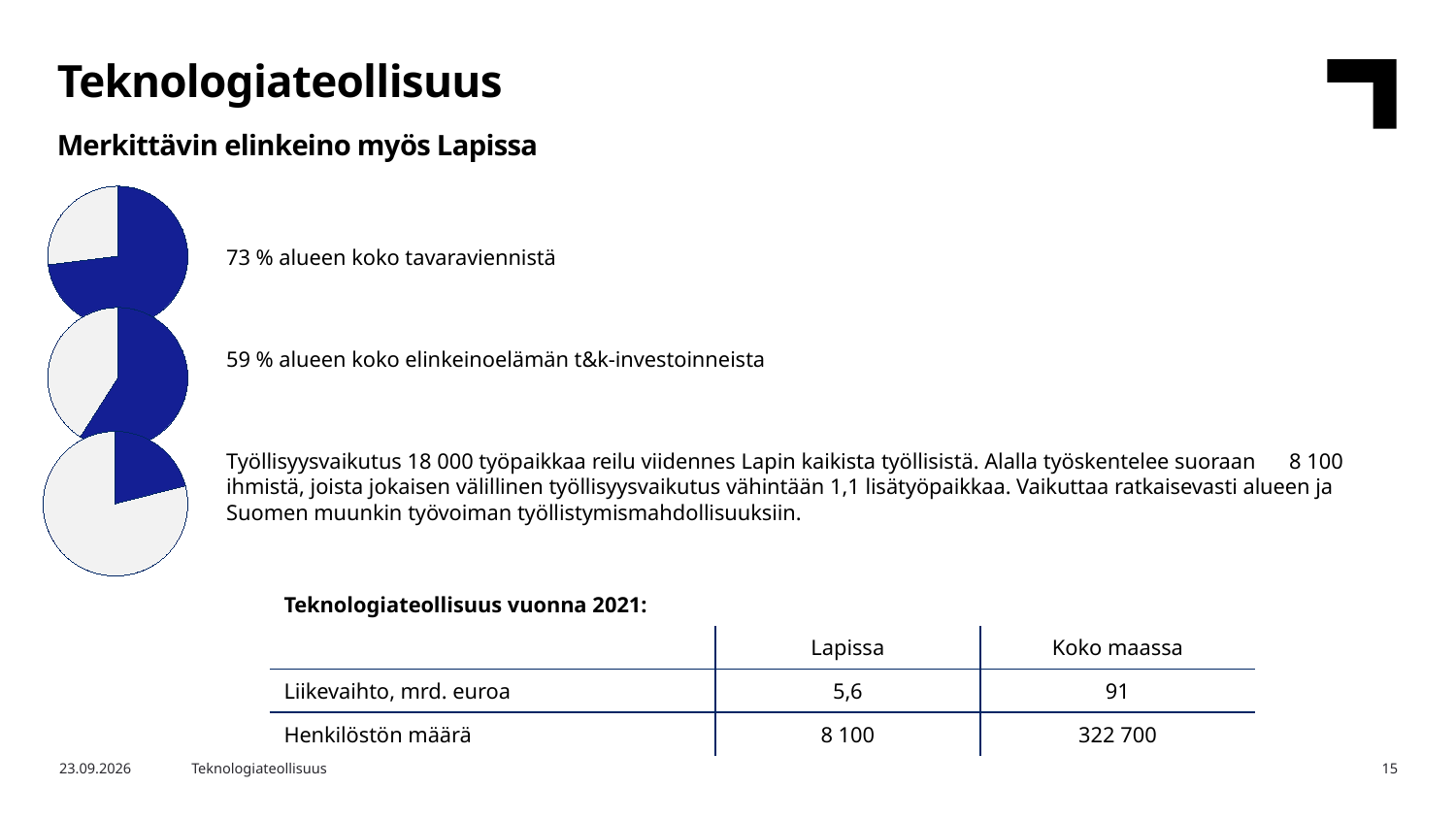
Is the blue slice in the bottom pie chart greater or less than 50% of the pie? less What colour is the larger slice in the top pie chart? Blue What colour is the larger slice in the bottom pie chart? Light grey Is the blue slice in the top pie chart greater or less than 50% of the pie? greater What kind of charts are the three charts on the left side of the slide? Pie charts How many pie charts are shown on the slide? 3 Which of the three pie charts has the largest blue slice? The top pie chart Is the blue slice in the top pie chart larger or smaller than the blue slice in the middle pie chart? larger How many slices does the top pie chart have? 2 Which of the three pie charts has the smallest blue slice? The bottom pie chart In the top pie chart, what share of the region's total goods exports does the blue slice represent, according to the text beside it? 73 % In the middle pie chart, what share of the region's business R&D investments does the blue slice represent, according to the text beside it? 59 %